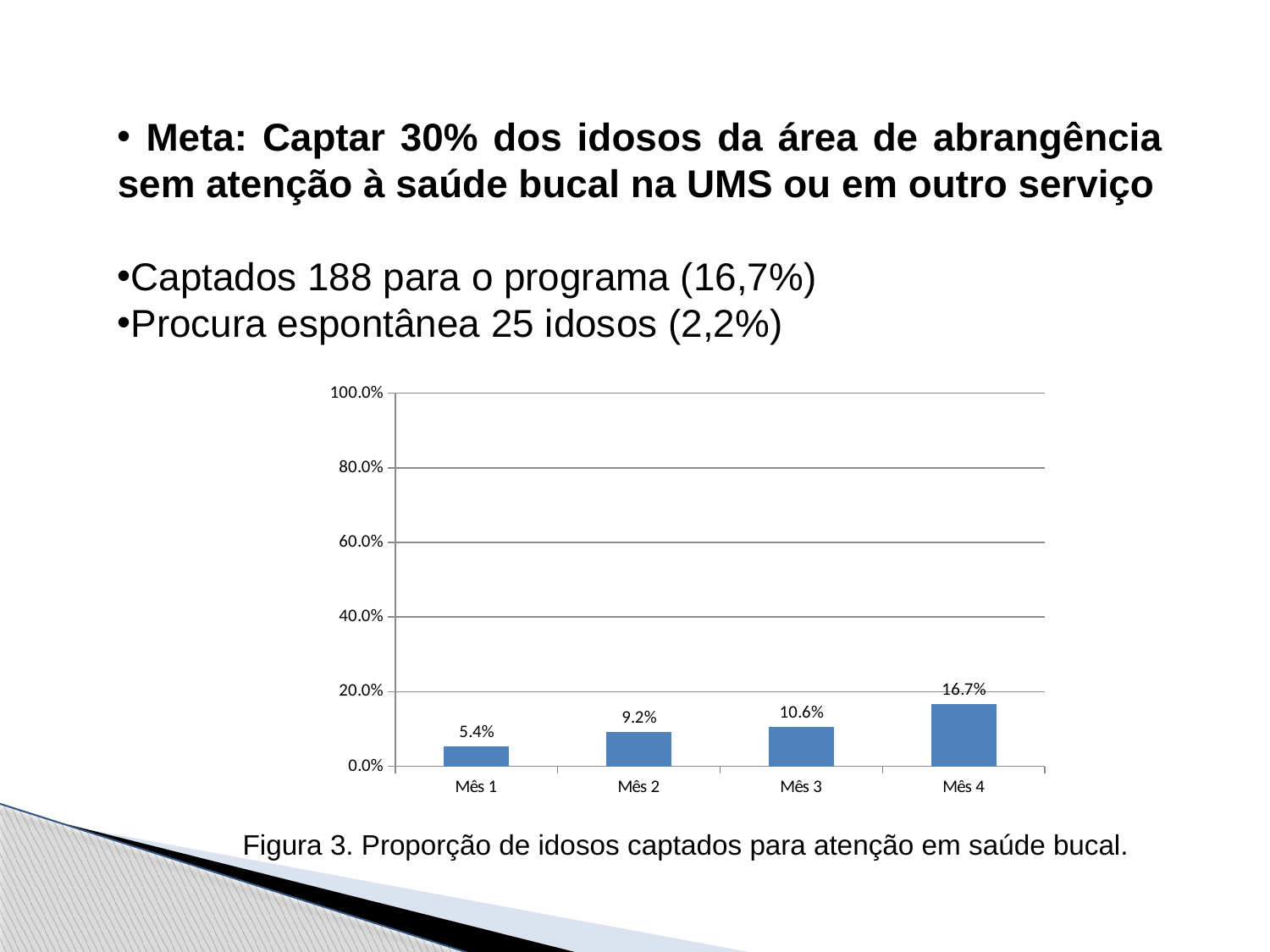
What is the difference between the values for Mês 4 and Mês 1? 11.3% What kind of chart is shown on the slide? bar chart What is the difference between the values for Mês 2 and Mês 1? 3.8% Which month has the highest value? Mês 4 What is the value for Mês 1? 5.4% Which month has the lowest value? Mês 1 What is the value for Mês 4? 16.7% Which is larger, the value for Mês 2 or the value for Mês 3? Mês 3 What is the value for Mês 3? 10.6% Do the values rise or fall from Mês 1 to Mês 4? rise Is the value for Mês 4 greater or less than 20.0%? less How many months are shown on the x axis? 4